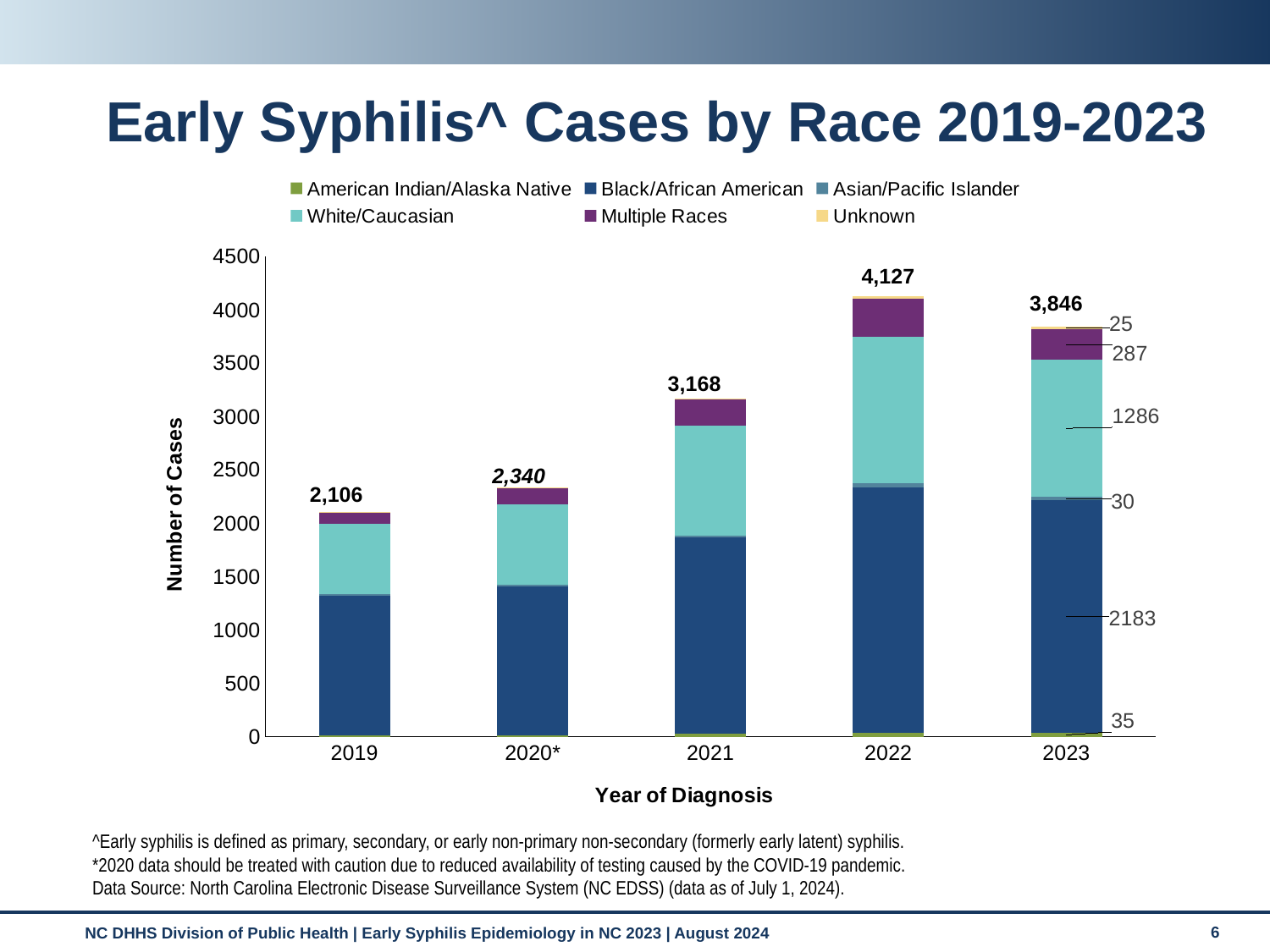
In 2023, how many cases are labeled for the Multiple Races segment? 287 What is the total number of early syphilis cases shown for 2022? 4,127 What is the difference between the total cases in 2022 and 2023? 281 What is the total number of early syphilis cases shown for 2019? 2,106 In 2023, how many cases are labeled for the White/Caucasian segment? 1286 What type of chart is shown on the slide? Stacked bar chart How many years are shown on the x axis? 5 Which year has the highest total number of early syphilis cases? 2022 Which year has the lowest total number of early syphilis cases? 2019 In 2023, how many cases are labeled for the Black/African American segment? 2183 How many race categories does the legend list? 6 Which year has more total cases, 2021 or 2020*? 2021